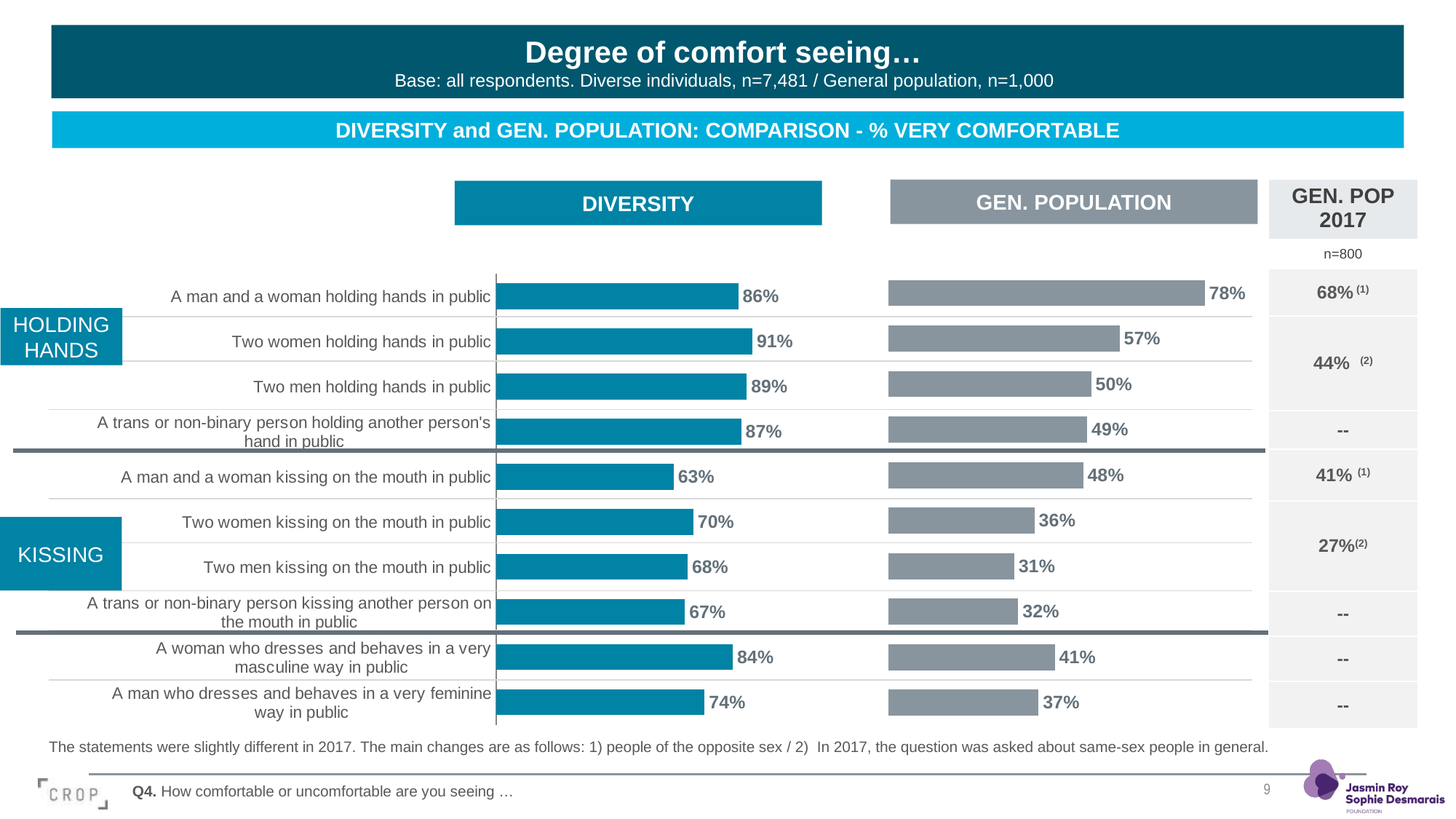
What is the difference between the DIVERSITY value and the GEN. POPULATION value for "Two women holding hands in public"? 34 percentage points In the DIVERSITY chart, what is the value for "Two men holding hands in public"? 89% In the GEN. POPULATION chart, which is larger: the value for "A woman who dresses and behaves in a very masculine way in public" or "A man who dresses and behaves in a very feminine way in public"? A woman who dresses and behaves in a very masculine way in public In the GEN. POPULATION chart, what is the value for "A trans or non-binary person kissing another person on the mouth in public"? 32% What colour are the bars in the DIVERSITY chart? Teal blue In the DIVERSITY chart, which category has the lowest value? A man and a woman kissing on the mouth in public In the GEN. POPULATION chart, which category has the lowest value? Two men kissing on the mouth in public In the GEN. POPULATION chart, which category has the highest value? A man and a woman holding hands in public What kind of chart is used to show the DIVERSITY values? Bar chart How many categories are plotted in the DIVERSITY chart? 10 In the DIVERSITY chart, which category has the highest value? Two women holding hands in public In the GEN. POPULATION chart, what is the value for "A man and a woman kissing on the mouth in public"? 48%